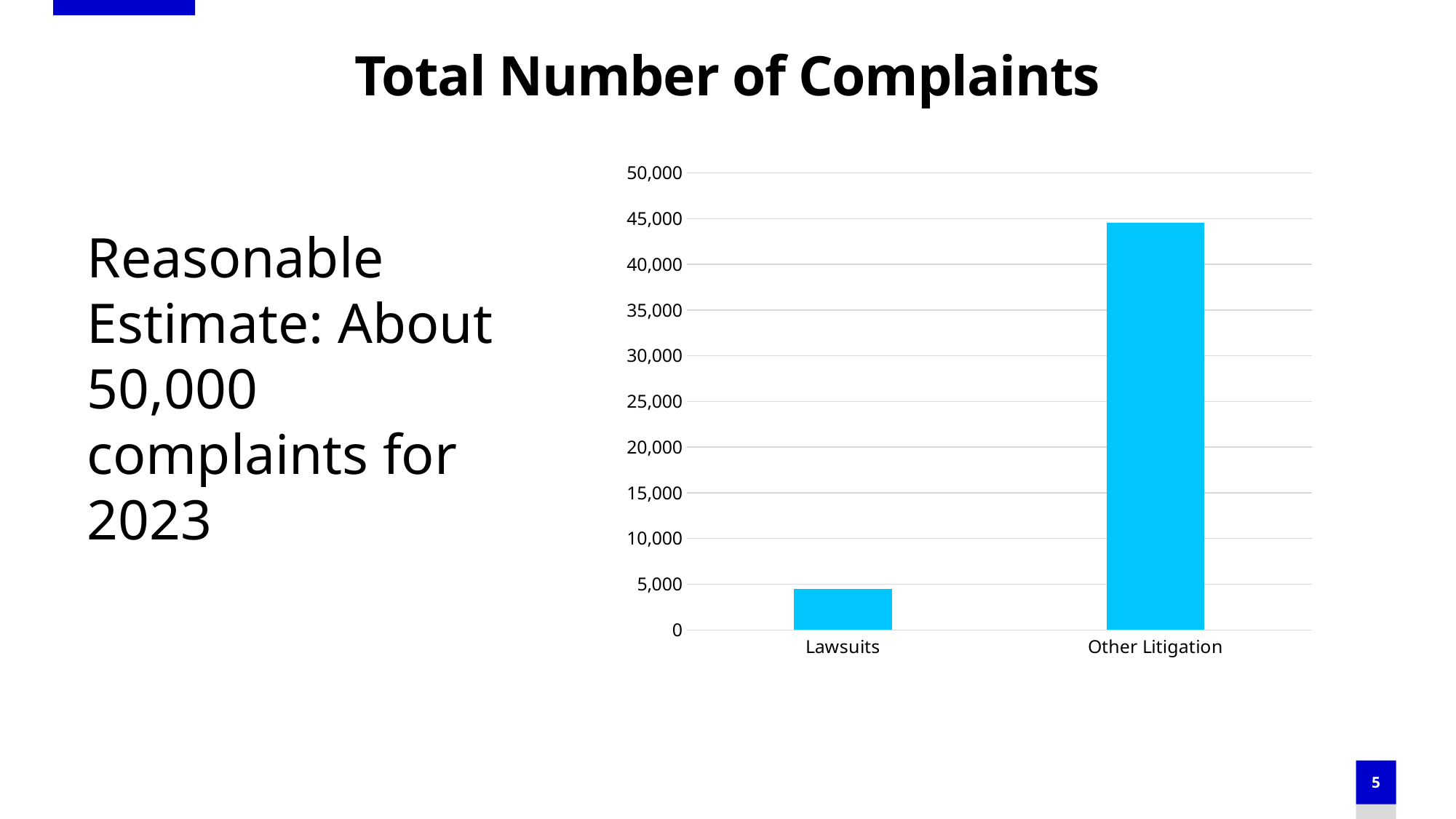
Which is larger, the value for Lawsuits or the value for Other Litigation? Other Litigation What kind of chart is shown on the slide? bar chart Is the value for Other Litigation greater or less than 40,000? greater Is the value for Lawsuits greater or less than 10,000? less Which category has the highest value in the chart? Other Litigation Which category has the lowest value in the chart? Lawsuits How many categories are plotted in the chart? 2 Do the values rise or fall moving from Lawsuits to Other Litigation along the x axis? rise What is the highest value shown on the chart's vertical axis? 50,000 What is the title of the slide containing the chart? Total Number of Complaints